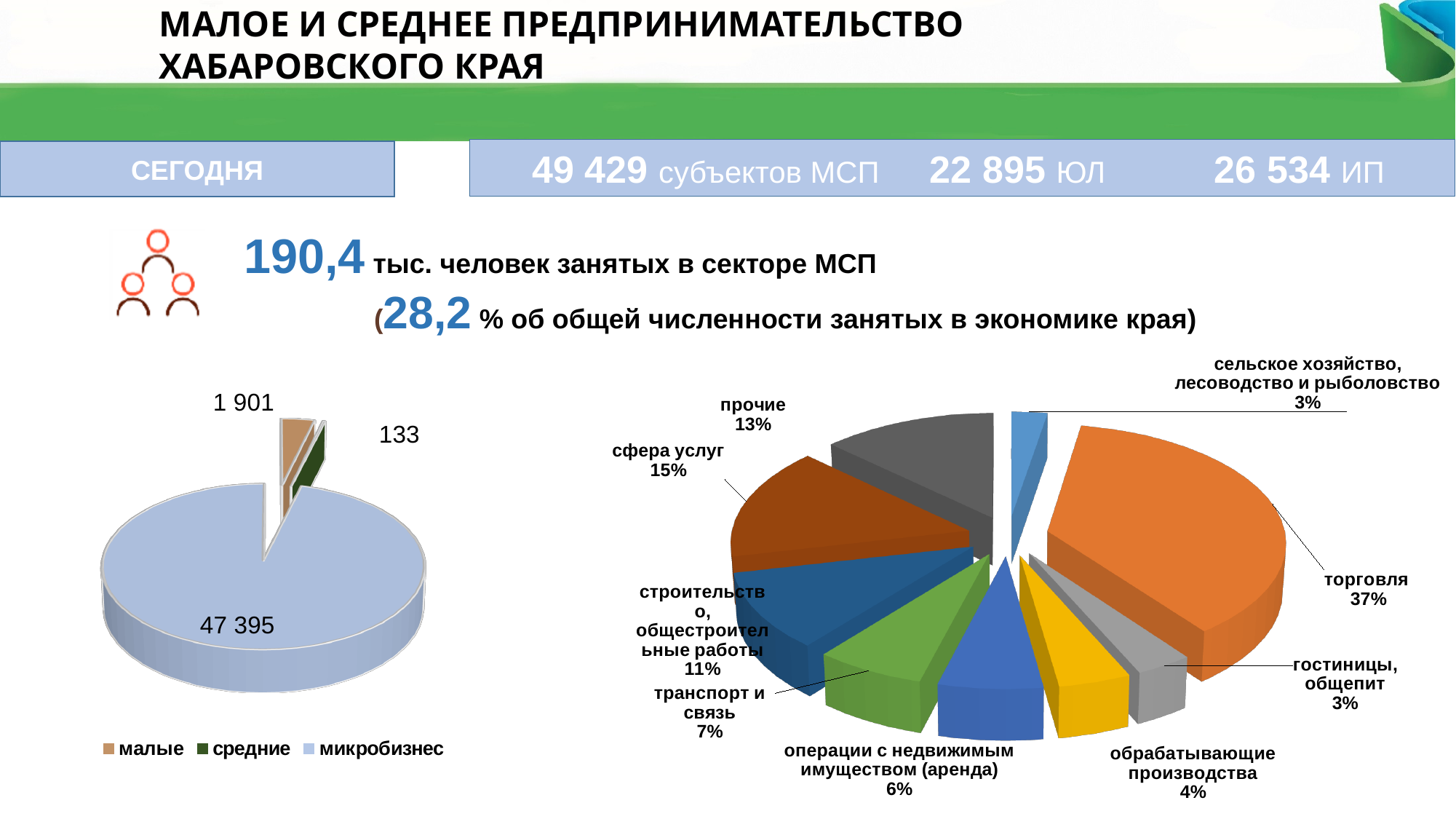
On the left pie chart, what is the difference between the values for малые and средние? 1 768 On the right pie chart, which is larger: прочие or строительство, общестроительные работы? прочие On the right pie chart, which sector has the largest share? торговля On the left pie chart, what is the value for средние? 133 On the left pie chart, how many categories does the legend list? 3 On the right pie chart, what share does торговля have? 37% What kind of chart is the chart on the left of the slide? pie chart On the right pie chart, what is the difference between the shares of торговля and транспорт и связь? 30% On the right pie chart, what share does сфера услуг have? 15% On the left pie chart, which category has the smallest value? средние On the right pie chart, how many sectors are shown? 9 On the left pie chart, what is the value for микробизнес? 47 395